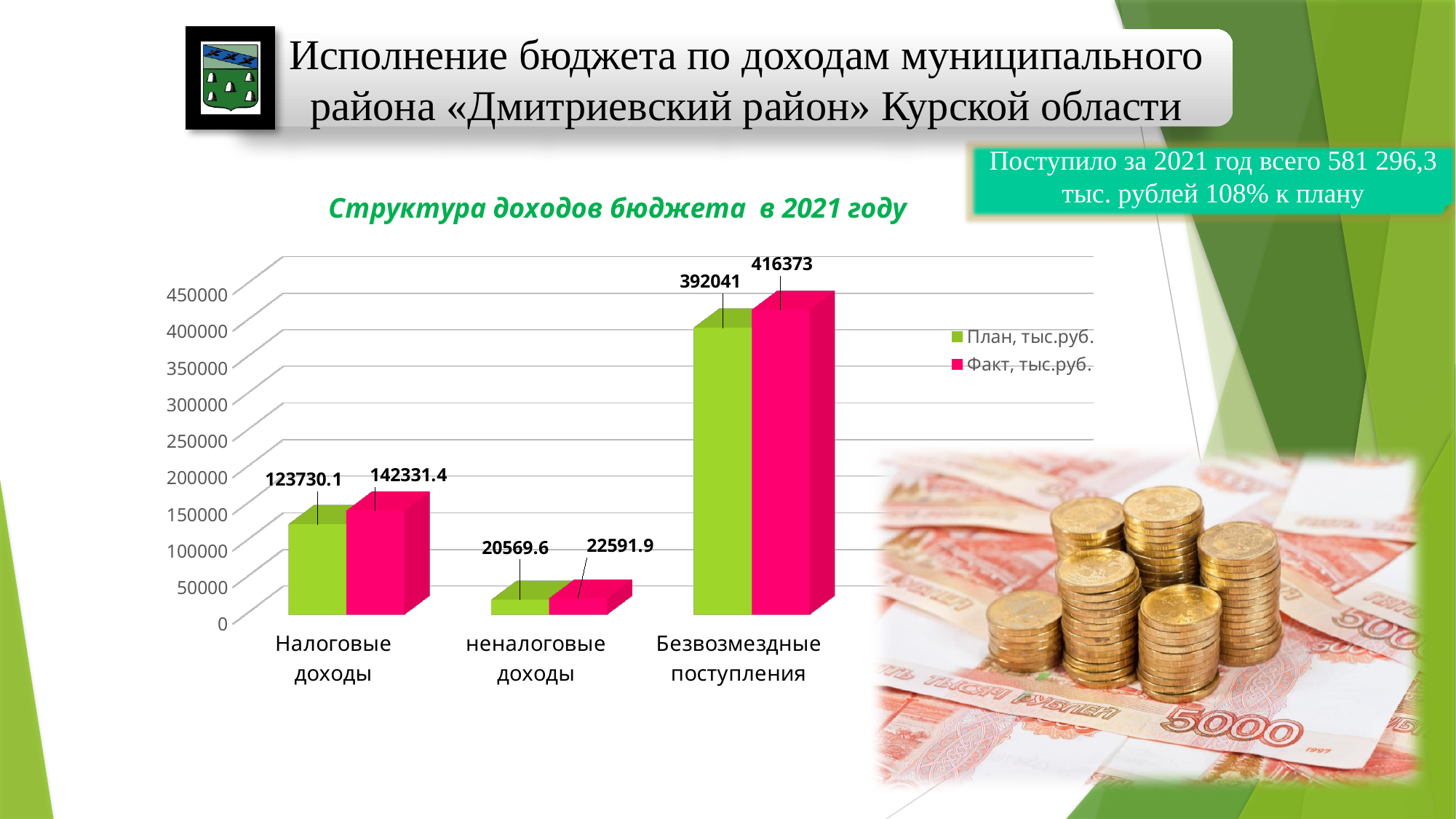
What is the План value for Безвозмездные поступления? 392041 Which is larger for неналоговые доходы, the План value or the Факт value? Факт What is the Факт value for Безвозмездные поступления? 416373 What is the План value for Налоговые доходы? 123730.1 Which category has the highest Факт value? Безвозмездные поступления How many categories are shown on the x axis of the chart? 3 What is the difference between the Факт and План values for Налоговые доходы? 18601.3 What is the difference between the Факт and План values for Безвозмездные поступления? 24332 How many series does the chart legend list? 2 Which category has the lowest План value? неналоговые доходы What is the Факт value for неналоговые доходы? 22591.9 What type of chart is shown on the slide? Bar chart